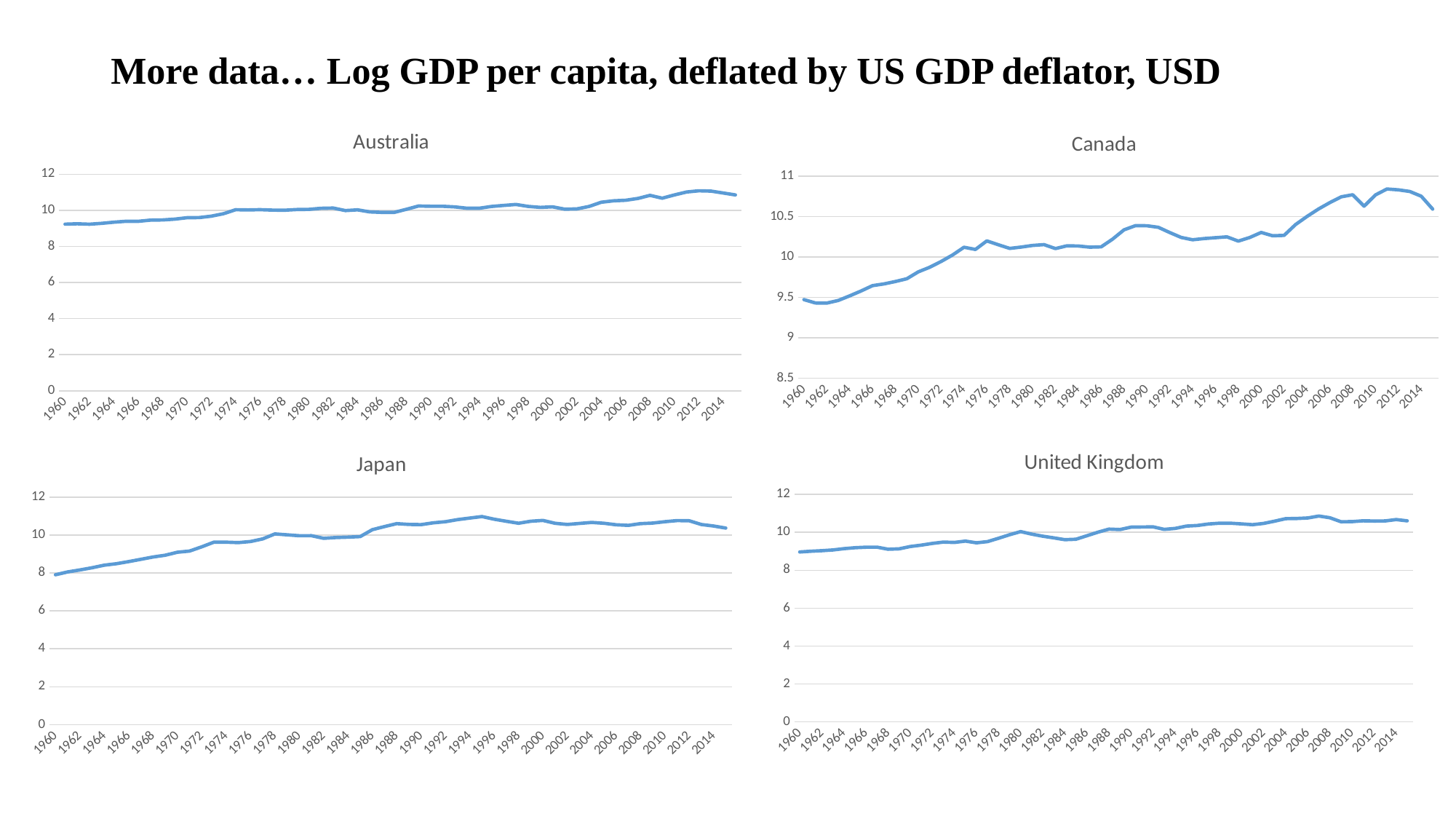
In the Canada chart, is the value for 2012 greater or less than 10.5? greater In the Canada chart, is the value for 1960 greater or less than 10? less How many series does the Canada chart plot? 1 In the Japan chart, does the value rise or fall overall from 1960 to 1996? rise In the United Kingdom chart, does the value rise or fall overall from 1960 to 2014? rise What is the lowest value shown on the vertical axis of the Canada chart? 8.5 What kind of chart is the Australia chart? line chart In the Japan chart, is the value for 1960 greater or less than 10? less How many charts are shown on the slide? 4 In the Canada chart, does the value rise or fall from 2012 to the last year shown? fall